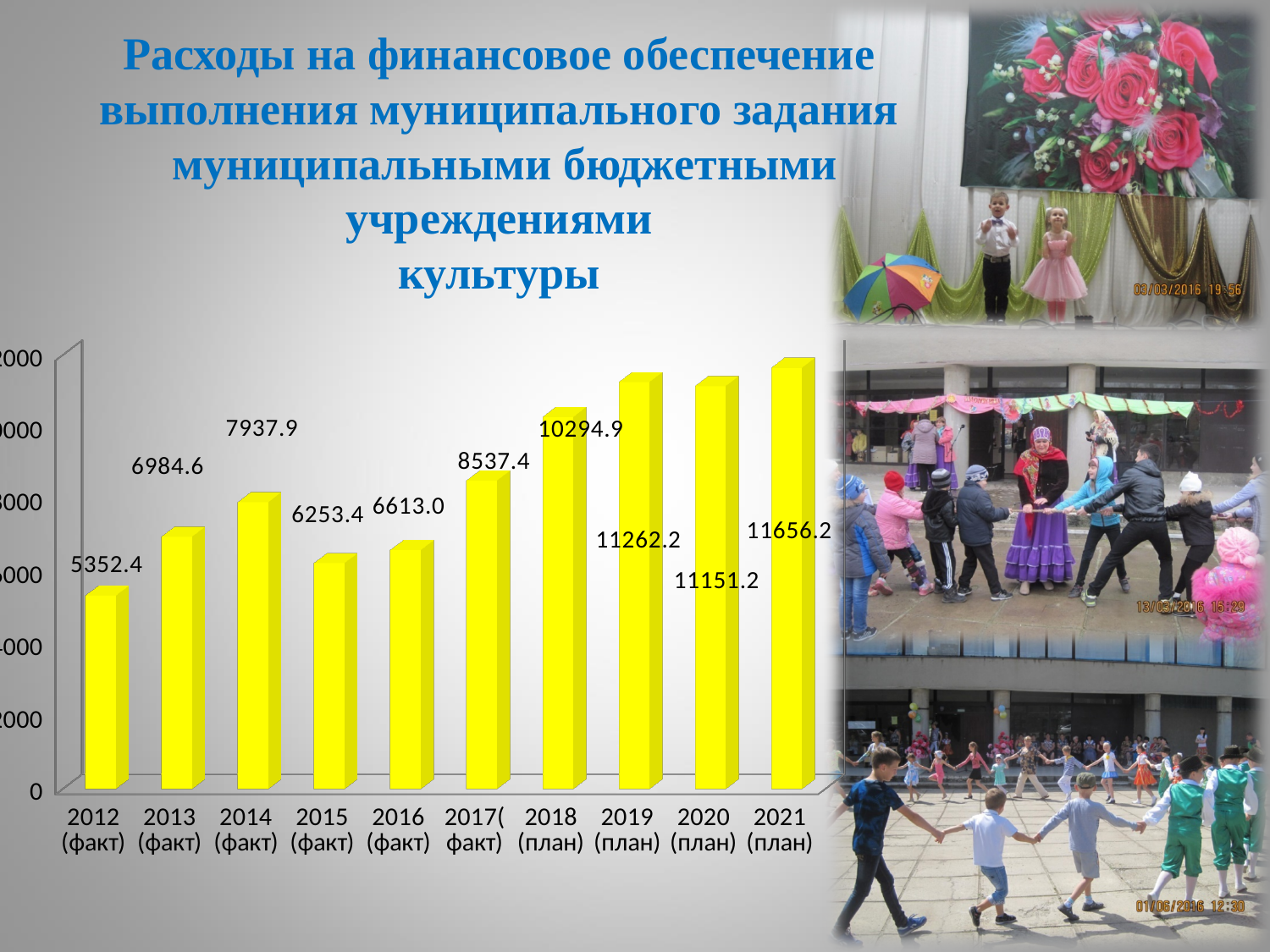
What is the difference between the values for 2021 (план) and 2012 (факт)? 6303.8 What is the value for 2016 (факт)? 6613.0 What is the value for 2012 (факт)? 5352.4 What colour are the bars in the chart? yellow What is the value for 2018 (план)? 10294.9 Do the values rise or fall from 2017 (факт) to 2021 (план)? rise Which year has the highest value? 2021 (план) Which is larger, the value for 2019 (план) or the value for 2020 (план)? 2019 (план) Which year has the lowest value? 2012 (факт) What is the difference between the values for 2014 (факт) and 2015 (факт)? 1684.5 What kind of chart is shown on the slide? bar chart How many years are shown on the x axis? 10